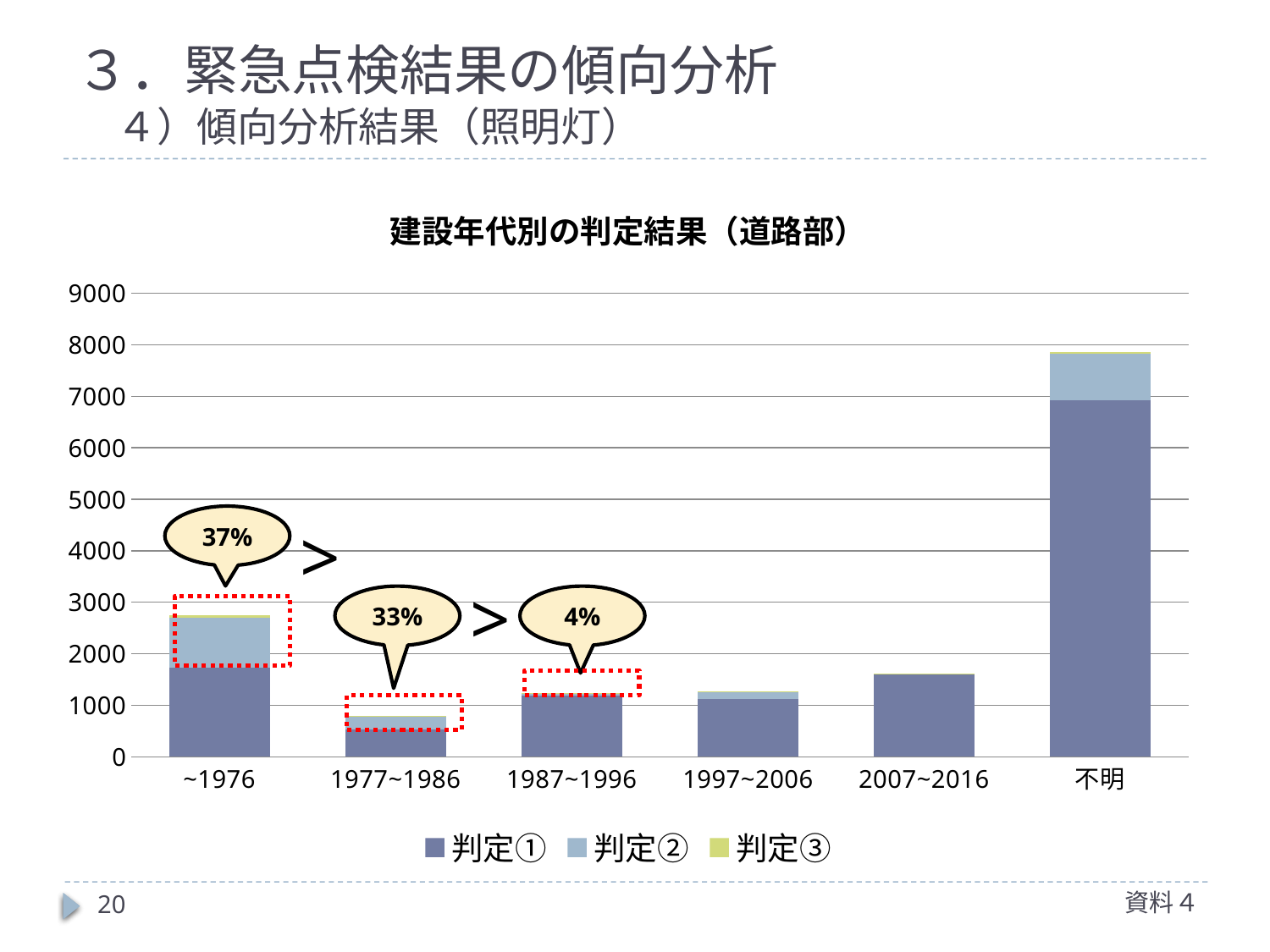
What kind of chart is shown on the slide? Stacked bar chart Is the total for 1977~1986 greater or less than 1000? less What percentage is shown in the callout above the ~1976 bar? 37% Which has the larger total, ~1976 or 1987~1996? ~1976 Is the total for 2007~2016 greater or less than 2000? less Which category has the shortest stacked bar? 1977~1986 How many series does the legend list? 3 What is the title of the chart? 建設年代別の判定結果（道路部） Is the total for 不明 greater or less than 7000? greater How many construction-period categories are shown on the x axis? 6 Which category has the tallest stacked bar? 不明